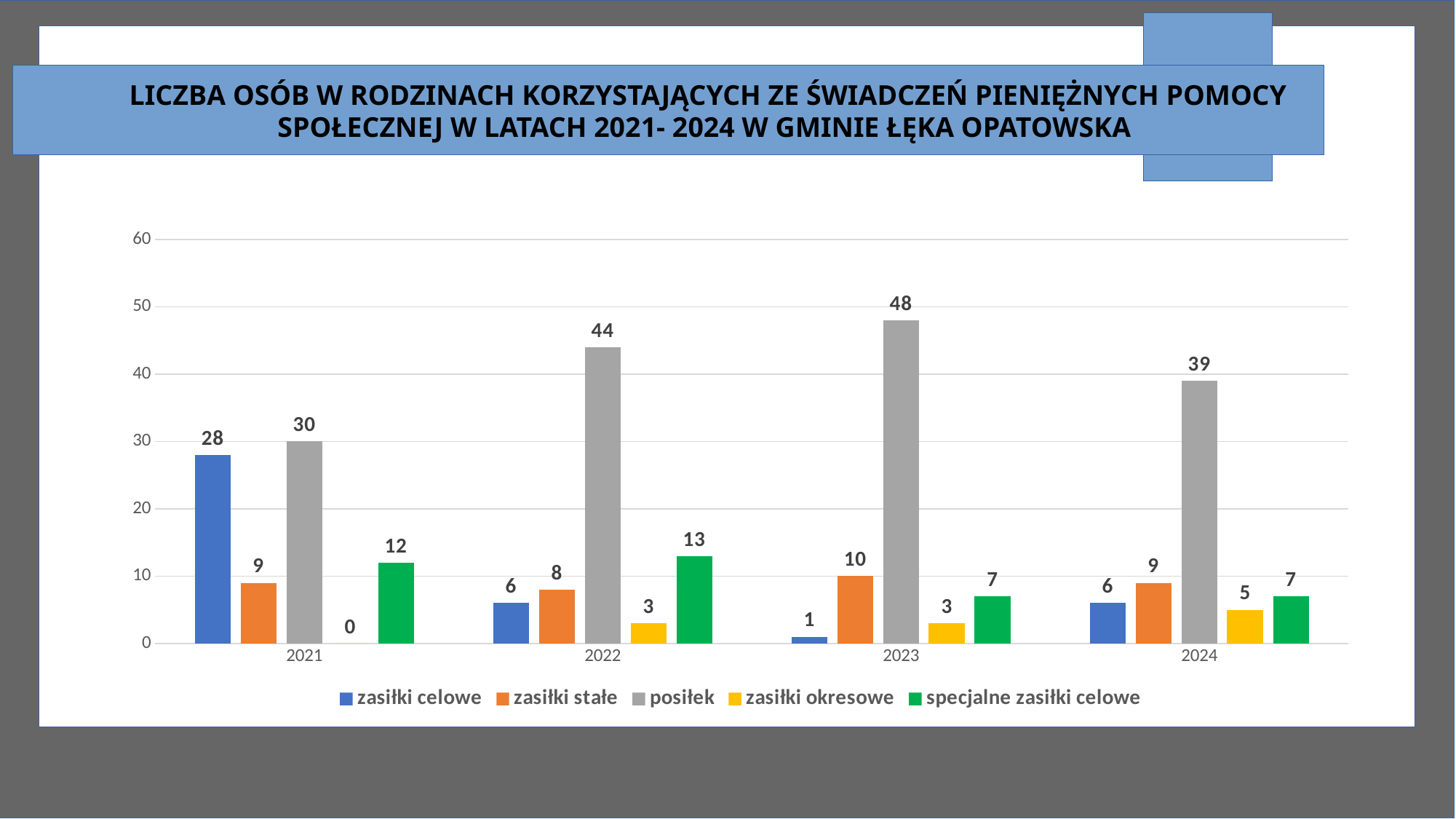
How many series does the legend list? 5 Does the value for zasiłki celowe rise or fall from 2021 to 2023? fall What is the value for zasiłki okresowe in 2024? 5 How many years are shown on the x axis? 4 Which is larger: specjalne zasiłki celowe in 2022 or zasiłki stałe in 2022? specjalne zasiłki celowe in 2022 In which year is the value for zasiłki celowe lowest? 2023 In which year is the value for posiłek highest? 2023 Which colour represents posiłek in the legend? grey What kind of chart is shown on the slide? bar chart What is the difference between posiłek in 2023 and posiłek in 2024? 9 What is the value for posiłek in 2023? 48 What is the value for zasiłki celowe in 2021? 28